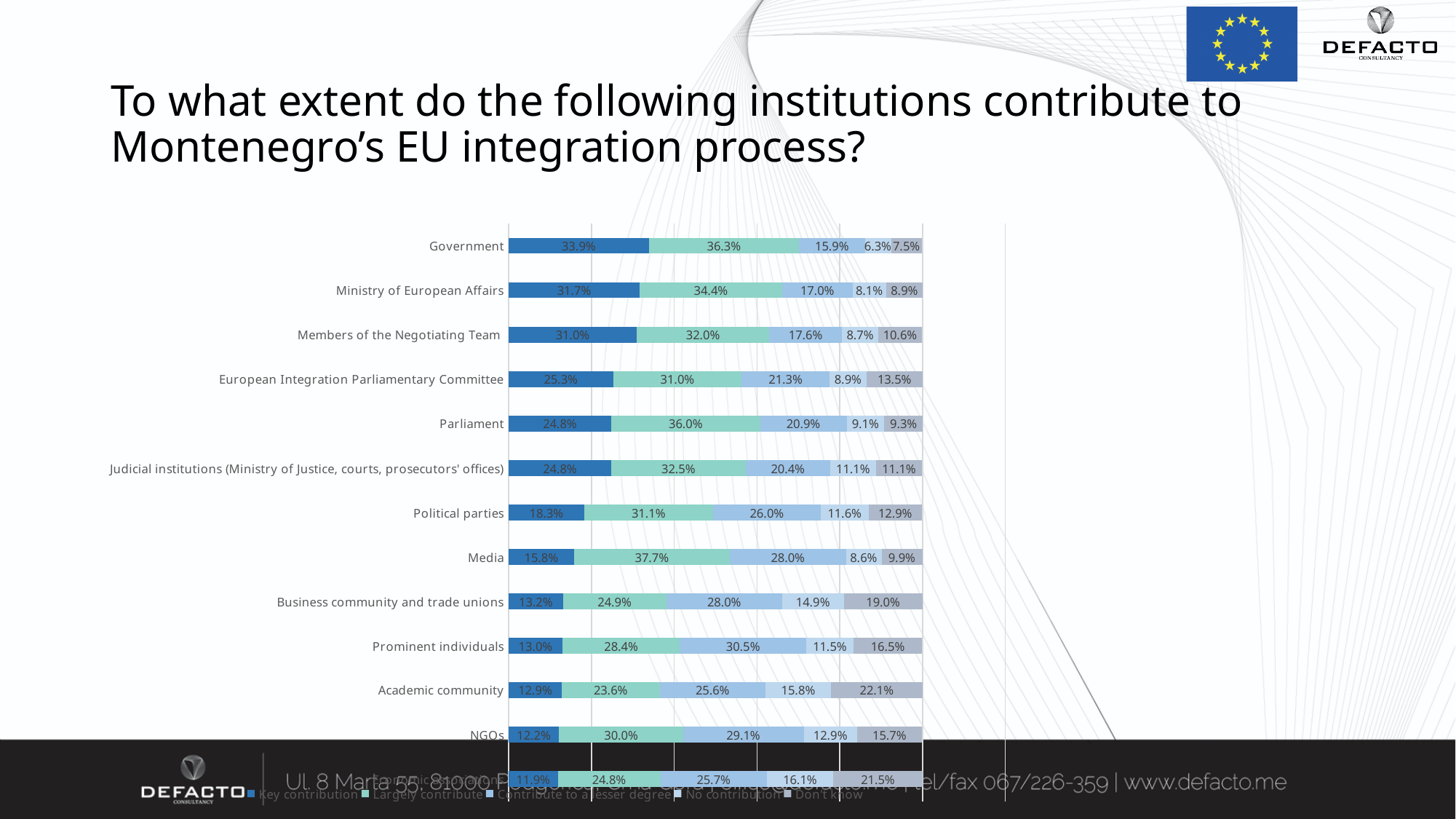
What is the 'Largely contribute' (second segment) value for Media? 37.7% How many series does the legend list? 5 What is the title of the chart on the slide? To what extent do the following institutions contribute to Montenegro's EU integration process? Which has the larger 'Largely contribute' (second segment) value: Parliament or Judicial institutions? Parliament What is the 'No contribution' (fourth segment) value for Political parties? 11.6% What is the 'Key contribution' (first segment) value for Government? 33.9% What is the 'Don't know' (last segment) value for Academic community? 22.1% What kind of chart is shown on the slide? Stacked bar chart Which institution has the highest 'Contribute to a lesser degree' (third segment) value? Prominent individuals Which institution has the highest 'Key contribution' (first segment) value? Government What is the difference between the 'Key contribution' values for Government and Ministry of European Affairs? 2.2 percentage points Which institution has the highest 'Don't know' (last segment) value? Academic community